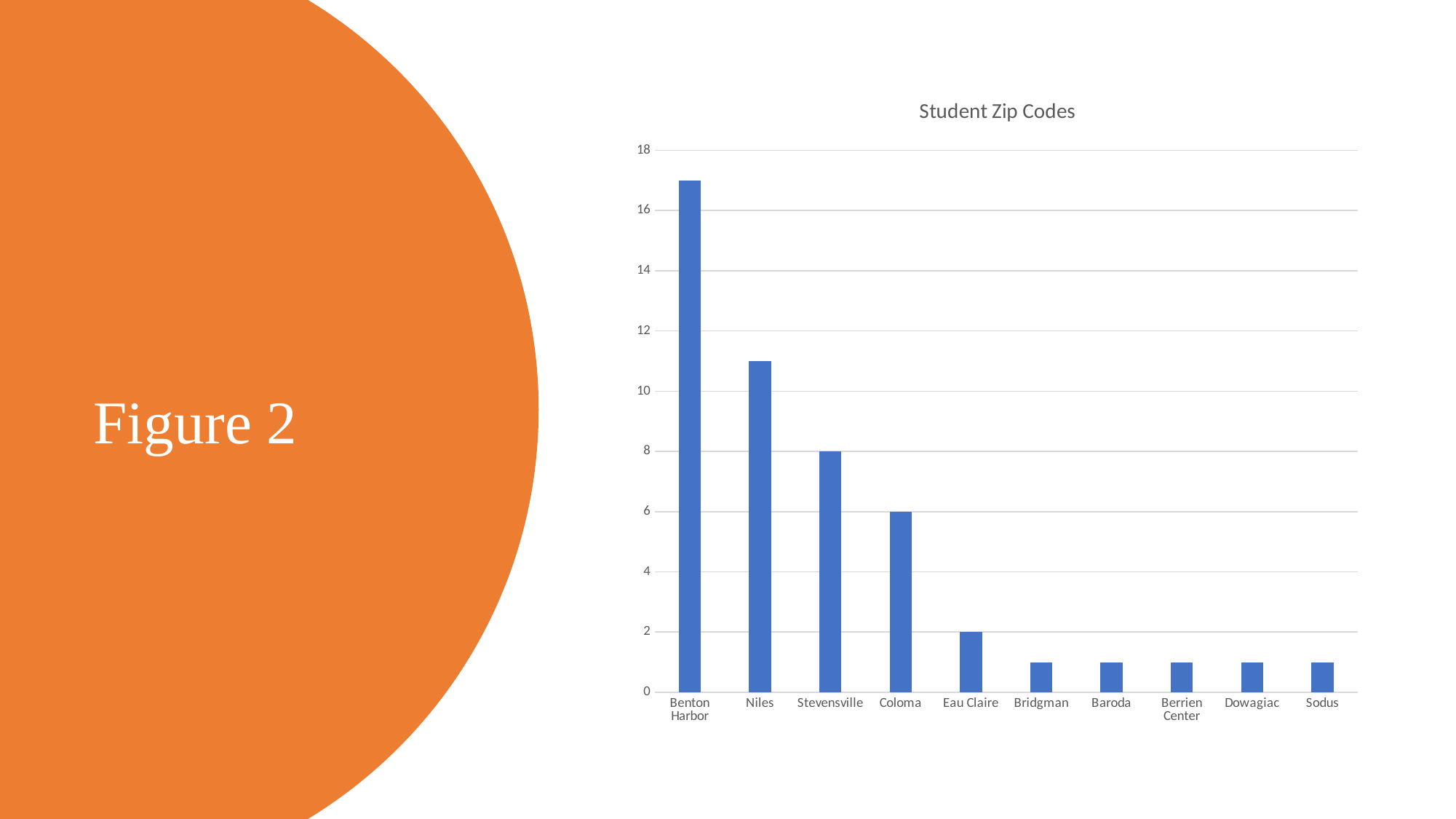
Which is larger, the value for Niles or the value for Stevensville? Niles Is the value for Niles greater or less than 10? greater What is the value for Eau Claire? 2 Is the value for Benton Harbor greater or less than 16? greater What type of chart is shown on the slide? bar chart Which category has the highest value in the chart? Benton Harbor What is the difference between the values for Stevensville and Coloma? 2 Is the value for Bridgman greater or less than 2? less What is the title of the chart? Student Zip Codes What is the value for Coloma? 6 How many categories are shown on the x axis of the chart? 10 What is the value for Stevensville? 8